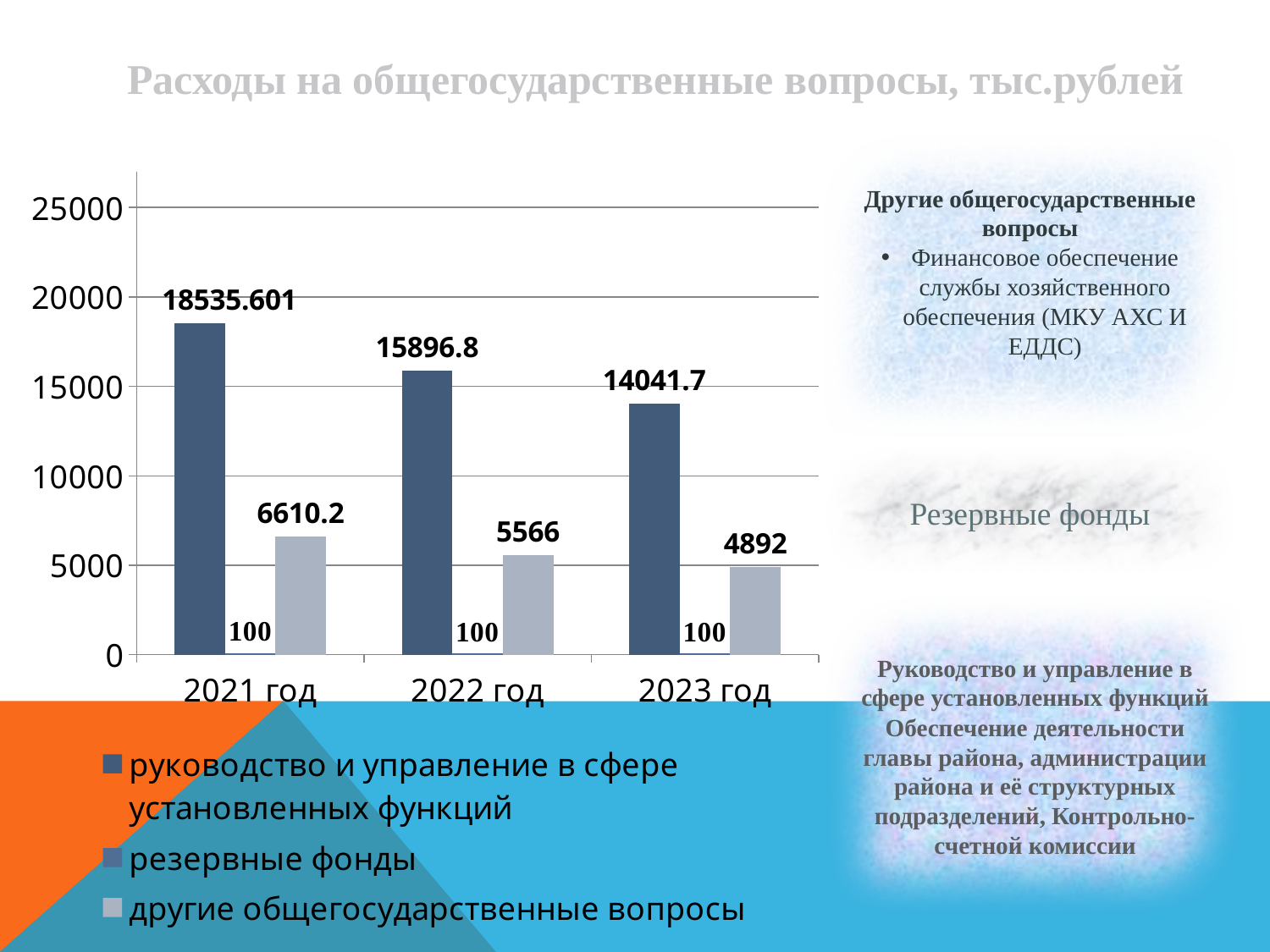
What is the value for "руководство и управление в сфере установленных функций" in 2023 год? 14041.7 What is the value for "руководство и управление в сфере установленных функций" in 2021 год? 18535.601 What is the difference between the "другие общегосударственные вопросы" values for 2021 год and 2023 год? 1718.2 What is the value for "другие общегосударственные вопросы" in 2022 год? 5566 Which is larger: "руководство и управление в сфере установленных функций" in 2022 год or in 2023 год? 2022 год How many years are shown on the x axis? 3 In which year is the value for "руководство и управление в сфере установленных функций" highest? 2021 год In which year is the value for "другие общегосударственные вопросы" lowest? 2023 год What kind of chart is shown on the slide? bar chart Do the values for "руководство и управление в сфере установленных функций" rise or fall from 2021 год to 2023 год? fall How many series does the legend list? 3